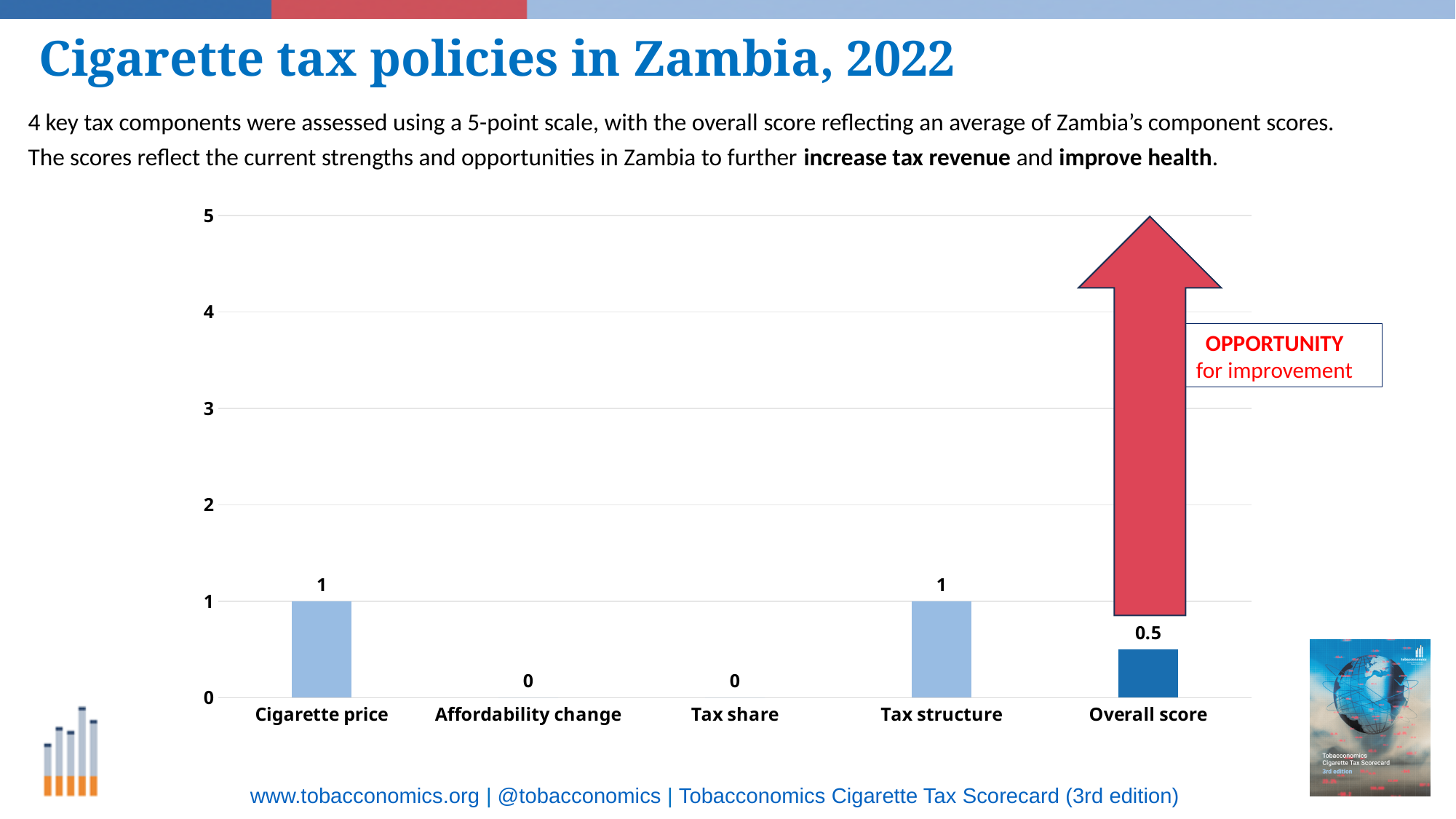
What kind of chart is shown on the slide? bar chart What is the value for Cigarette price? 1 What is the Overall score? 0.5 What is the highest value shown on the y axis? 5 Is the value for Overall score greater or less than 1? less What does the red arrow label on the chart say? OPPORTUNITY for improvement What is the value for Tax share? 0 What is the difference between the value for Cigarette price and the Overall score? 0.5 How many categories are shown on the x axis? 5 Which is larger, the value for Tax structure or the Overall score? Tax structure What is the value for Tax structure? 1 What is the value for Affordability change? 0